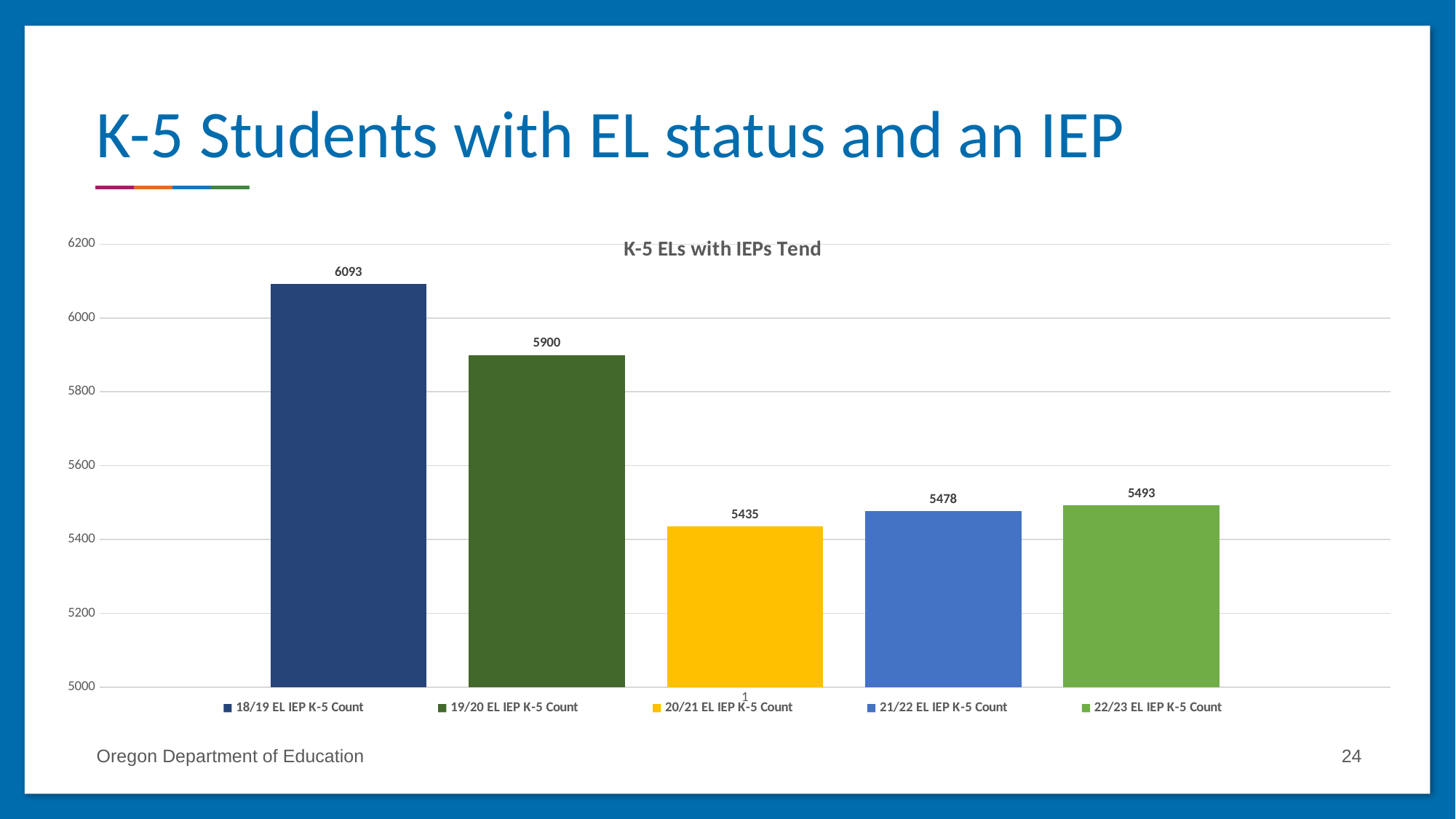
What is the difference between the 18/19 and 19/20 EL IEP K-5 Counts? 193 What is the 18/19 EL IEP K-5 Count? 6093 What is the title of the chart? K-5 ELs with IEPs Tend Which series has the highest value? 18/19 EL IEP K-5 Count What is the 22/23 EL IEP K-5 Count? 5493 What is the difference between the 22/23 and 21/22 EL IEP K-5 Counts? 15 What is the 20/21 EL IEP K-5 Count? 5435 What kind of chart is shown on the slide? Bar chart Is the 19/20 EL IEP K-5 Count greater or less than 6000? less Which is larger, the 19/20 EL IEP K-5 Count or the 21/22 EL IEP K-5 Count? 19/20 EL IEP K-5 Count How many series does the legend list? 5 Which series has the lowest value? 20/21 EL IEP K-5 Count